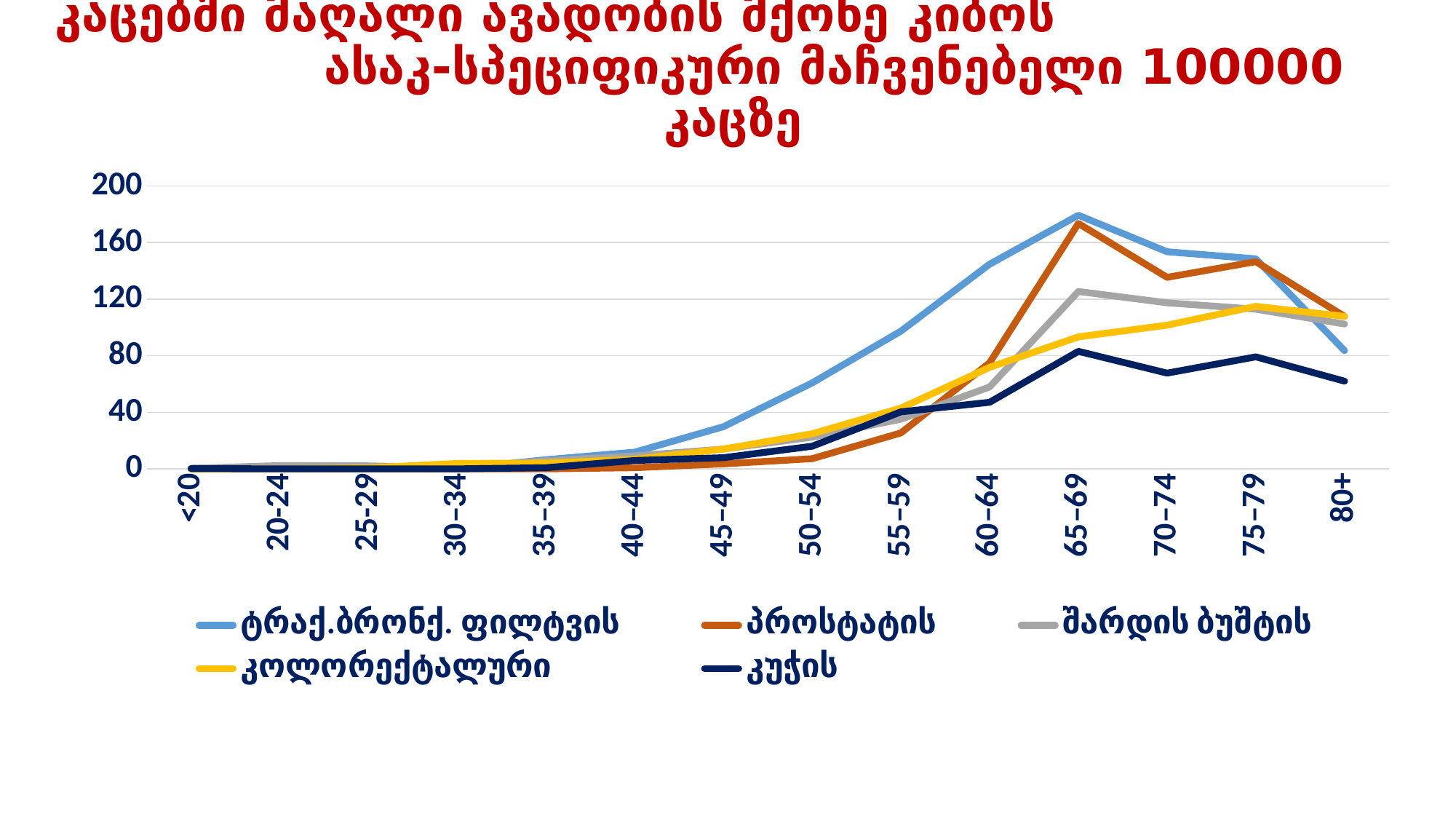
Is the value for ტრაქ.ბრონქ. ფილტვის at 65-69 greater or less than 160? greater Is the value for პროსტატის at 50-54 greater or less than 40? less In which age group does the პროსტატის series reach its highest value? 65-69 How many age groups are shown along the x axis? 14 At 80+, which is larger: ტრაქ.ბრონქ. ფილტვის or პროსტატის? პროსტატის In which age group does the ტრაქ.ბრონქ. ფილტვის series reach its highest value? 65-69 Is the value for კუჭის at 80+ greater or less than 80? less How many series does the legend list? 5 Does the ტრაქ.ბრონქ. ფილტვის series rise or fall from 40-44 to 65-69? rise At 60-64, which is larger: ტრაქ.ბრონქ. ფილტვის or პროსტატის? ტრაქ.ბრონქ. ფილტვის What kind of chart is shown on the slide? line chart